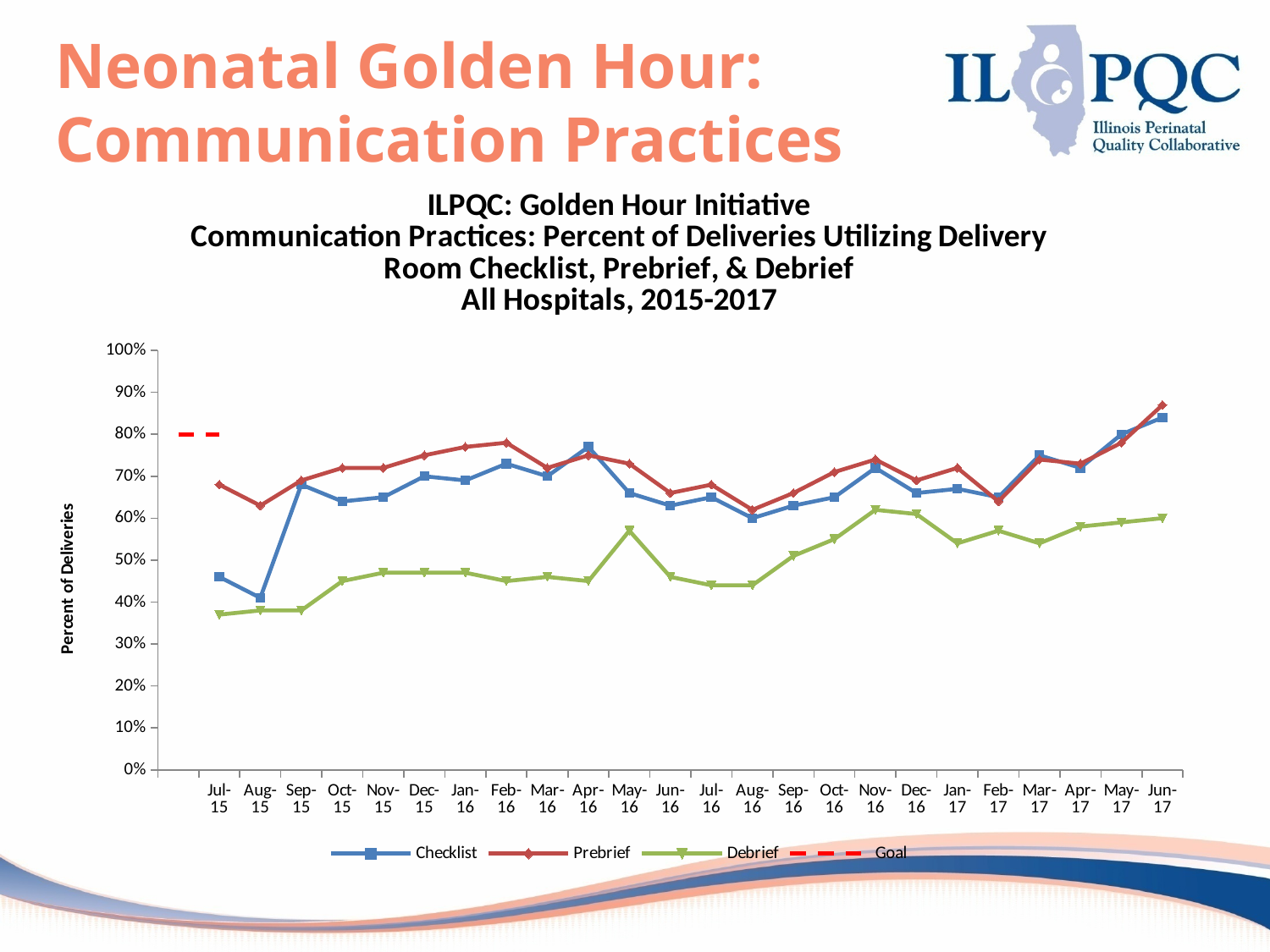
At what percentage is the Goal line drawn? 80% How many months are plotted along the x axis? 24 Is the Debrief value for Jul-15 greater or less than 40%? less Is the Prebrief value for Jun-17 greater or less than 80%? greater In which month does the Checklist series reach its lowest value? Aug-15 Is the Checklist value for Jul-15 greater or less than 50%? less What kind of chart is shown on the slide? line chart In Jul-15, which is higher, the Prebrief value or the Checklist value? Prebrief In which month does the Prebrief series reach its highest value? Jun-17 How many series does the chart legend list? 4